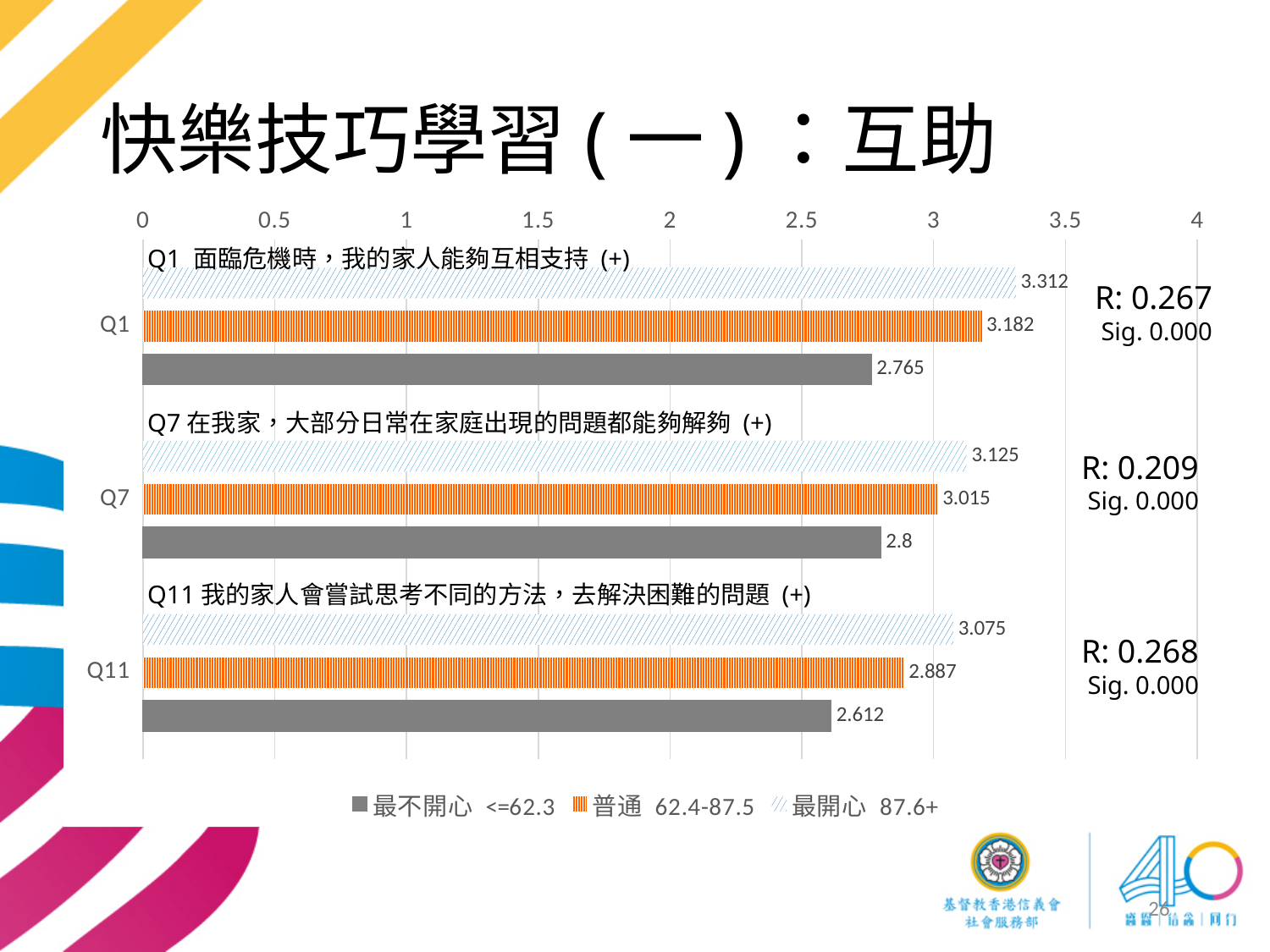
How many question categories are plotted on the chart? 3 What is the difference between the 最開心 87.6+ and 最不開心 <=62.3 values for Q1? 0.547 For Q7, which is larger: the 普通 62.4-87.5 value or the 最不開心 <=62.3 value? 普通 62.4-87.5 What is the R value shown next to Q11? 0.268 Is the 最不開心 <=62.3 value for Q7 greater or less than 3? less What kind of chart is shown on the slide? bar chart What is the value for 最不開心 <=62.3 for Q11? 2.612 What is the value for 普通 62.4-87.5 for Q7? 3.015 Which question has the highest value for the 最開心 87.6+ series? Q1 How many series does the legend list? 3 What is the value for 最開心 87.6+ for Q1? 3.312 Which question has the lowest value for the 最不開心 <=62.3 series? Q11